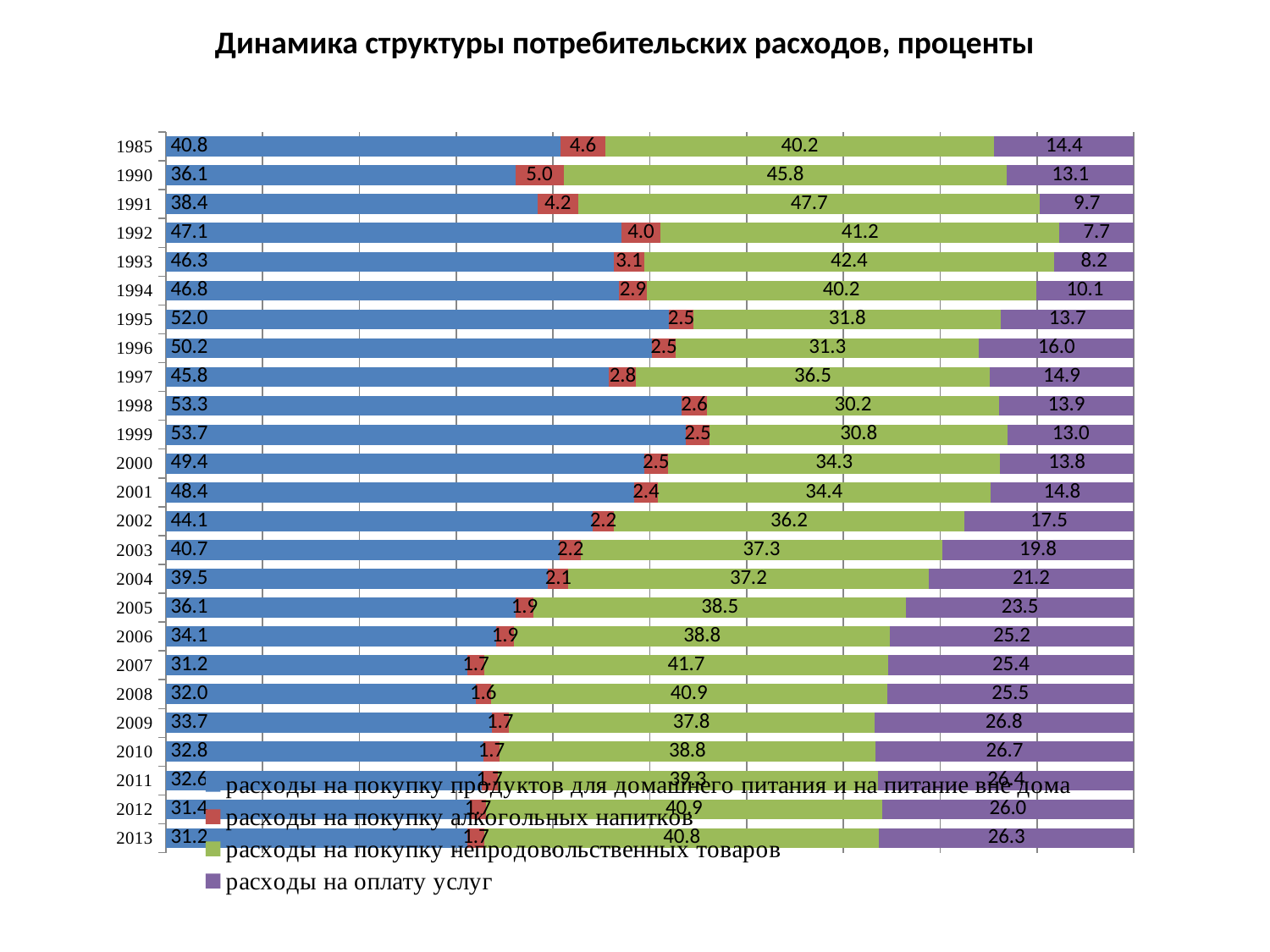
In which year is the value for расходы на оплату услуг the lowest? 1992 What is the value for расходы на покупку алкогольных напитков in 1985? 4.6 How many series does the legend list? 4 What is the value for расходы на покупку продуктов для домашнего питания и на питание вне дома in 1995? 52.0 In 2005, which is larger: расходы на покупку продуктов для домашнего питания и на питание вне дома or расходы на покупку непродовольственных товаров? расходы на покупку непродовольственных товаров What is the value for расходы на оплату услуг in 2013? 26.3 In which year is the value for расходы на покупку продуктов для домашнего питания и на питание вне дома the highest? 1999 What kind of chart is shown on the slide? Stacked bar chart What is the total of the stacked bar for 1985? 100.0 How many years are shown on the vertical axis? 25 In which year is the value for расходы на покупку алкогольных напитков the highest? 1990 What is the difference between the value for расходы на оплату услуг in 2013 and in 1985? 11.9